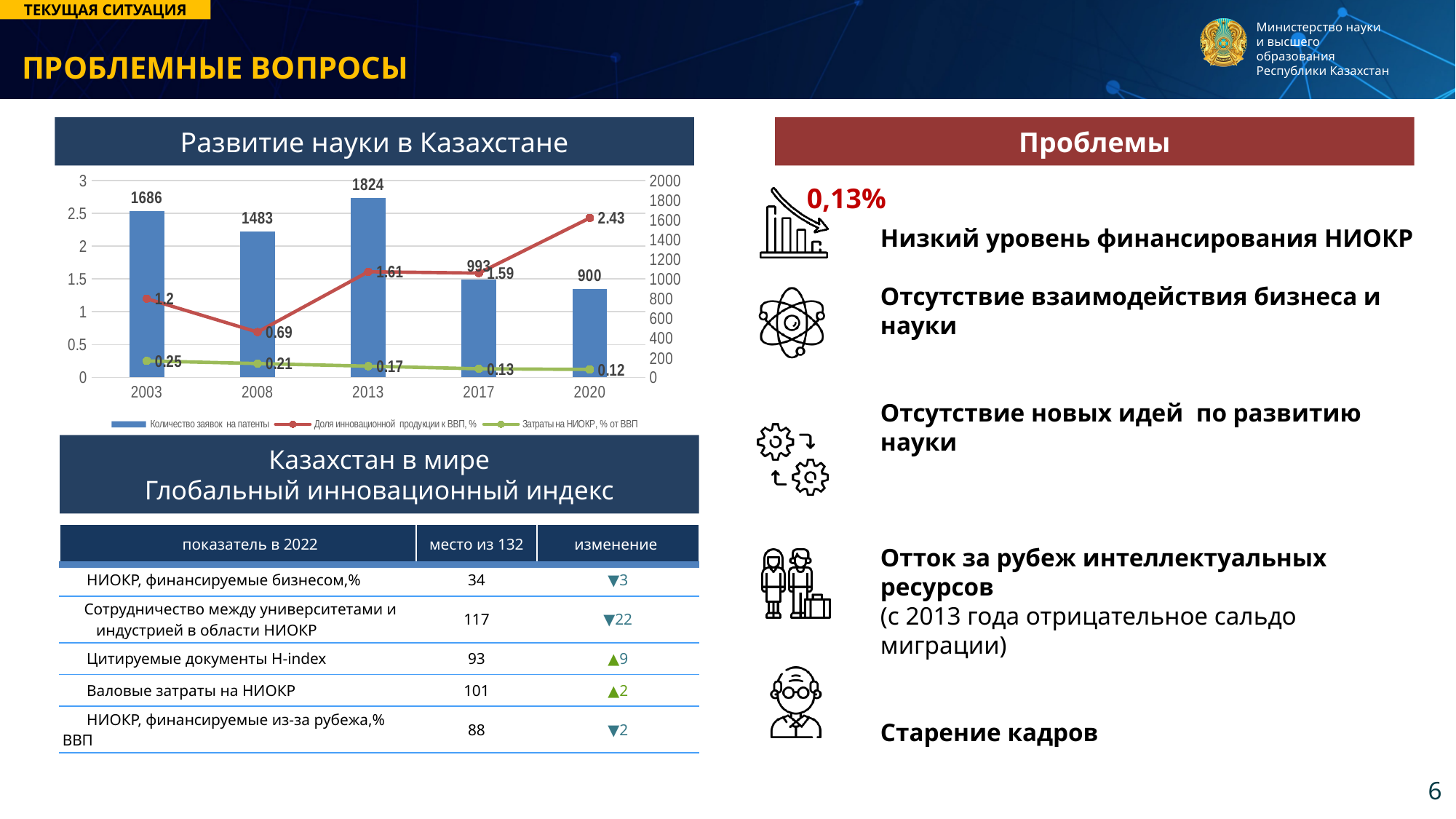
Does Затраты на НИОКР, % от ВВП rise or fall from 2003 to 2020? fall In which year is the number of patent applications (Количество заявок на патенты) the highest? 2013 How many patent applications (Количество заявок на патенты) are shown for 2013? 1824 Which year has more patent applications, 2017 or 2020? 2017 What is the value of Доля инновационной продукции к ВВП, % for 2020? 2.43 What is the value of Затраты на НИОКР, % от ВВП for 2003? 0.25 What is the difference in patent applications between 2003 and 2008? 203 How many series does the chart legend list? 3 How many years are shown on the x axis of the chart? 5 In which year is the number of patent applications (Количество заявок на патенты) the lowest? 2020 What is the title of the chart? Развитие науки в Казахстане In which year is Доля инновационной продукции к ВВП, % the lowest? 2008